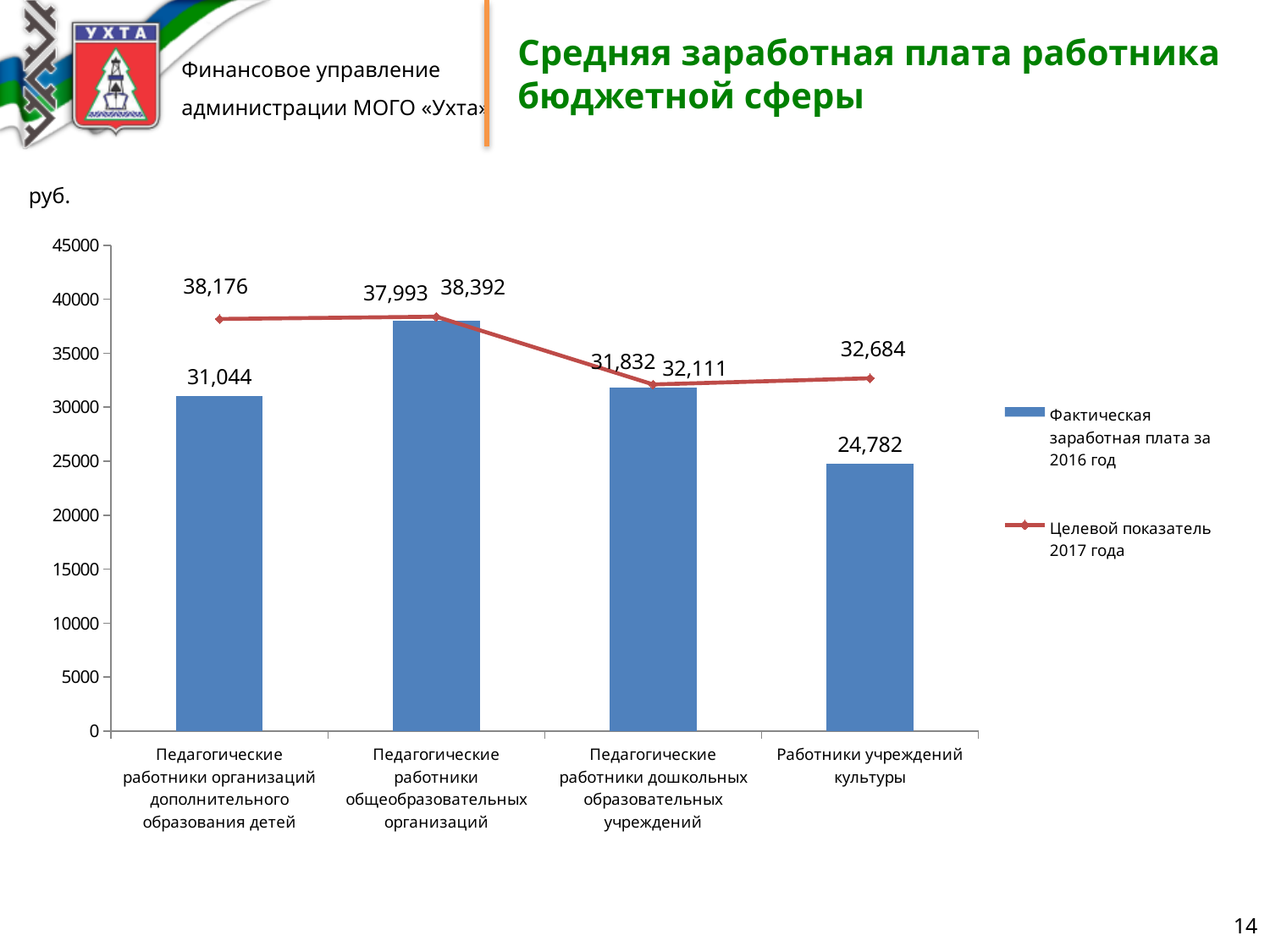
What is the difference between the 2017 target and the actual 2016 salary for Педагогические работники организаций дополнительного образования детей? 7,132 How many series does the legend list? 2 What unit is indicated for the values on the chart? руб. How many categories are shown on the x axis? 4 Is the actual 2016 salary for Работники учреждений культуры greater or less than 25000? less What is the actual 2016 salary (Фактическая заработная плата за 2016 год) for Педагогические работники общеобразовательных организаций? 37,993 What is the actual 2016 salary for Педагогические работники дошкольных образовательных учреждений? 31,832 What is the difference between the 2017 target and the actual 2016 salary for Работники учреждений культуры? 7,902 What is the 2017 target (Целевой показатель 2017 года) for Работники учреждений культуры? 32,684 Which is larger: the actual 2016 salary for Педагогические работники организаций дополнительного образования детей or for Педагогические работники дошкольных образовательных учреждений? Педагогические работники дошкольных образовательных учреждений Which category has the lowest actual 2016 salary? Работники учреждений культуры Which category has the highest 2017 target value? Педагогические работники общеобразовательных организаций